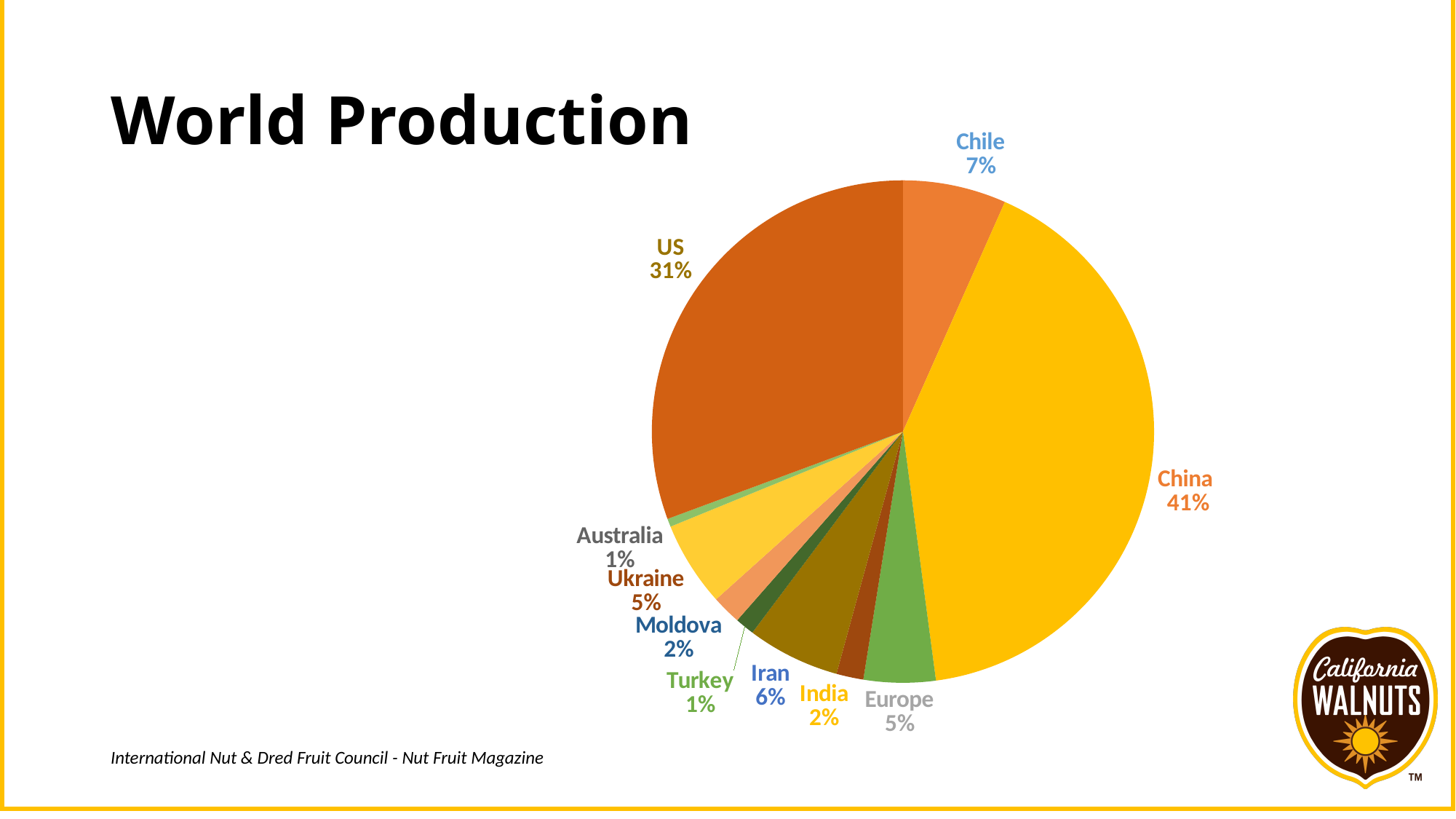
What share of world production does China account for? 41% What is the title of the chart? World Production What share of world production does the US account for? 31% What is the combined share of Moldova and India? 4% What is the difference in percentage points between China's share and the US share? 10 What percentage is shown for Chile? 7% Which country has the largest share of world production? China How many slices does the pie chart have? 10 What percentage is shown for Ukraine? 5% What percentage is shown for Iran? 6% What kind of chart is shown on the slide? Pie chart Which has a larger share of world production, Chile or Iran? Chile